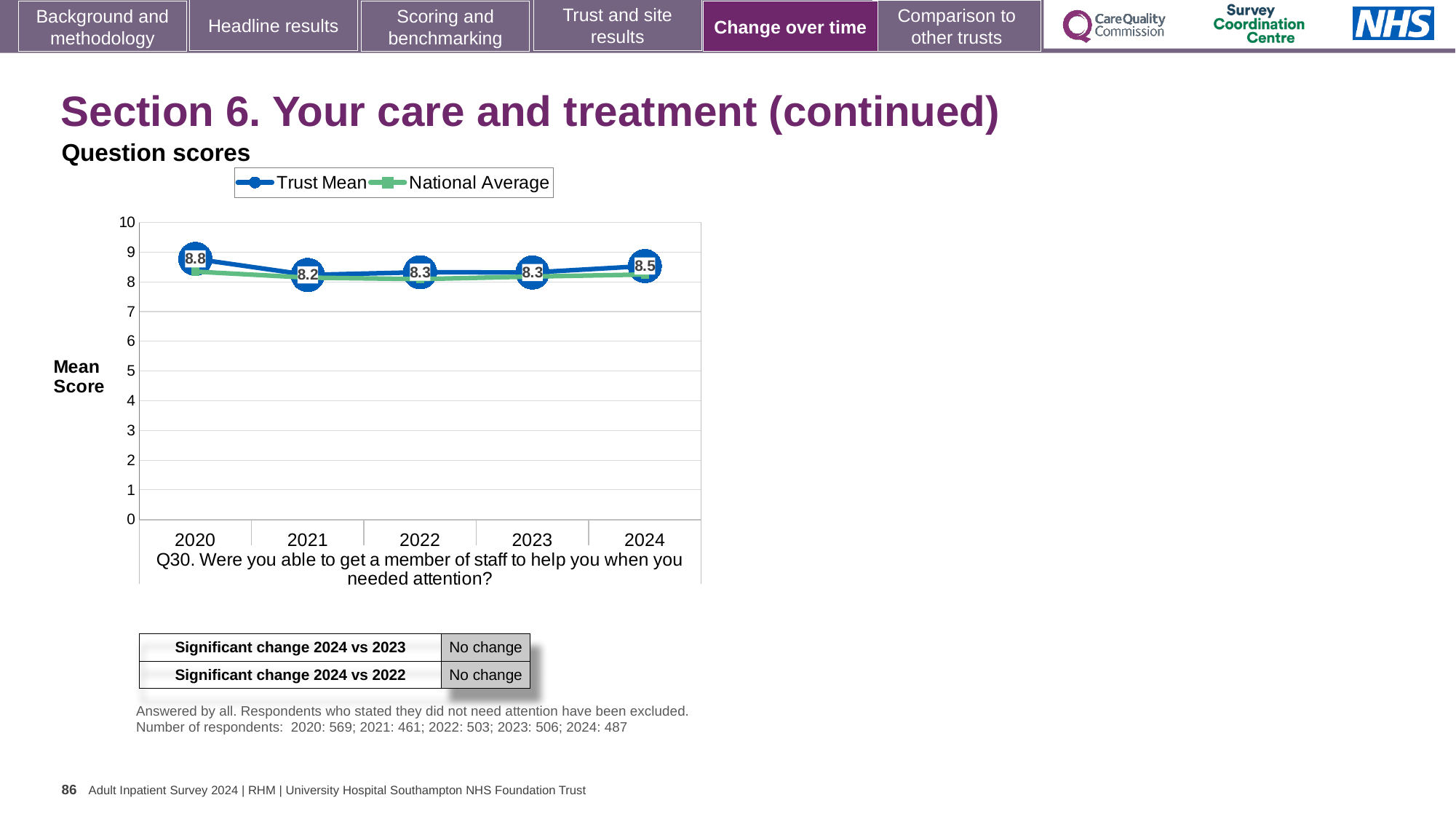
What is the Trust Mean score for 2024? 8.5 How many series does the legend list? 2 Which is larger, the Trust Mean score in 2024 or in 2023? 2024 What kind of chart is shown? Line chart In which year is the Trust Mean score highest? 2020 In which year is the Trust Mean score lowest? 2021 Does the Trust Mean score rise or fall from 2020 to 2021? Fall Is the National Average value for 2020 greater or less than 8? greater What is the Trust Mean score for 2020? 8.8 What is the Trust Mean score for 2021? 8.2 How many years are shown on the x axis? 5 What is the difference between the Trust Mean score in 2020 and in 2021? 0.6